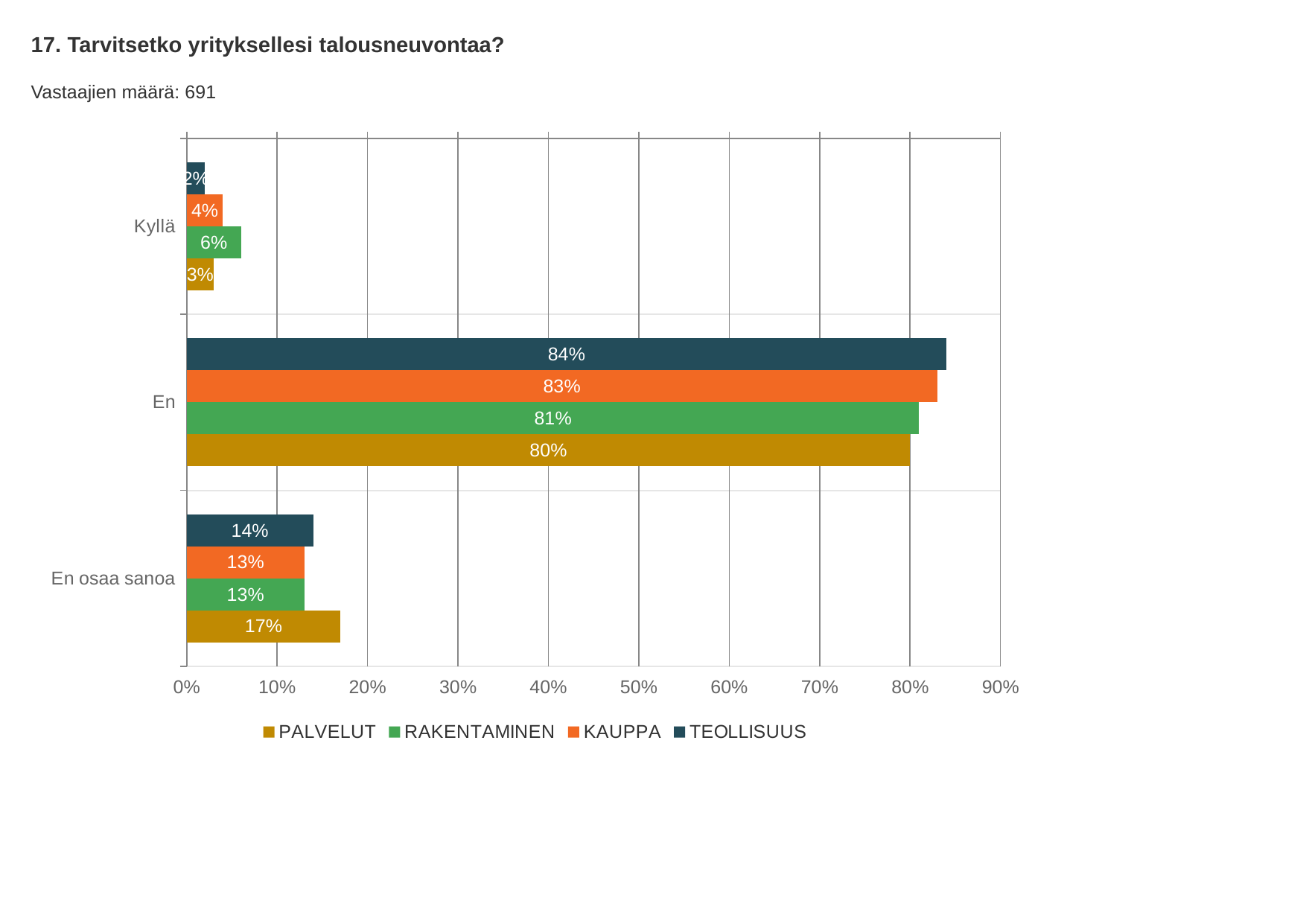
Which series has the lowest value in the 'En' category? PALVELUT What is the value for TEOLLISUUS in the 'En' category? 84% What is the value for PALVELUT in the 'En osaa sanoa' category? 17% How many series does the legend list? 4 In the 'En osaa sanoa' category, which is larger: PALVELUT or TEOLLISUUS? PALVELUT What is the value for RAKENTAMINEN in the 'Kyllä' category? 6% What is the number of respondents stated on the slide? 691 What is the value for KAUPPA in the 'En' category? 83% What kind of chart is shown on the slide? bar chart What is the difference between the TEOLLISUUS and PALVELUT values in the 'En' category? 4% Which series has the highest value in the 'Kyllä' category? RAKENTAMINEN How many response categories are shown on the chart? 3